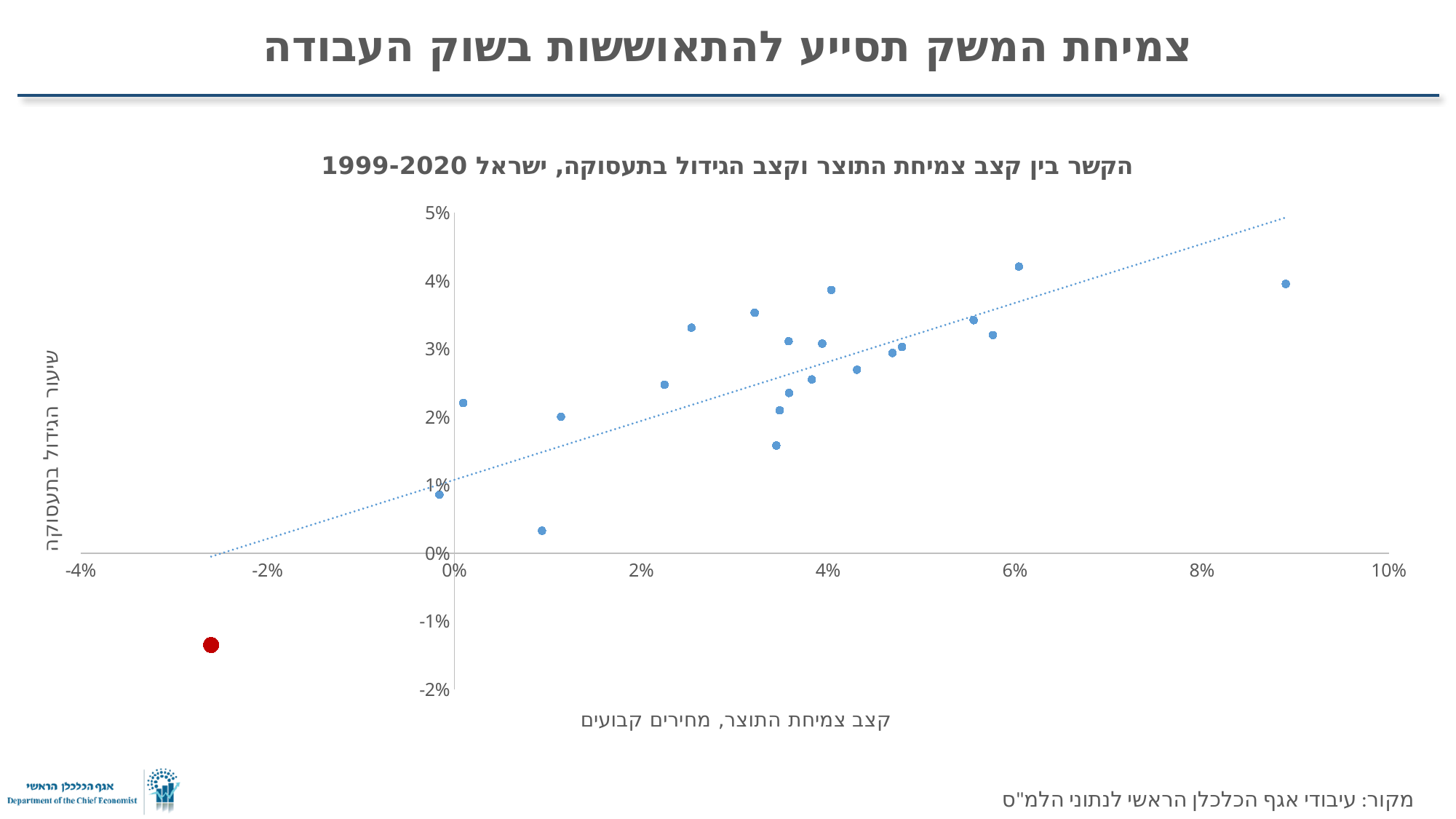
As GDP growth increases along the x axis, does employment growth generally rise or fall? Rise Is the employment growth value of the lowest blue point greater or less than 1%? less What is the title of the chart? הקשר בין קצב צמיחת התוצר וקצב הגידול בתעסוקה, ישראל 1999-2020 What kind of chart is shown on the slide? Scatter chart Is the employment growth value of the red point greater or less than -1%? less What is the label of the horizontal axis? קצב צמיחת התוצר, מחירים קבועים What is the maximum value shown on the horizontal axis? 10% Is the employment growth value of the highest blue point greater or less than 4%? greater Which point has the lowest employment growth value, the red point or any of the blue points? The red point How many data points are plotted on the chart? 22